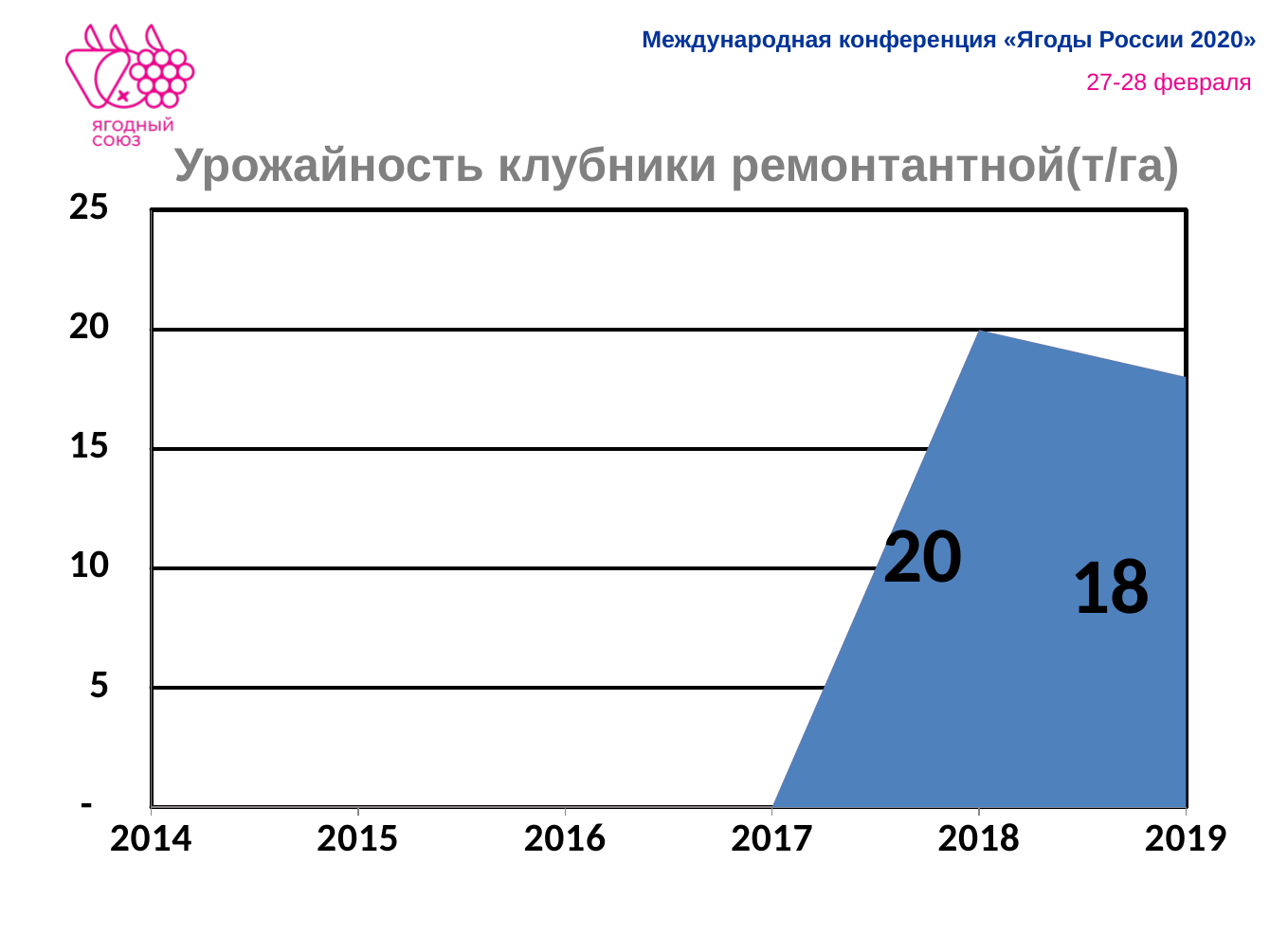
How many years are labelled on the x axis of the chart? 6 Which year has the larger yield value, 2018 or 2019? 2018 What type of chart is shown on the slide? area chart What is the yield value shown for 2018? 20 Is the yield value for 2018 greater or less than 25? less Does the yield value rise or fall from 2018 to 2019? fall Which year has the highest yield value on the chart? 2018 Is the yield value for 2019 greater or less than 15? greater What is the difference between the yield values for 2018 and 2019? 2 What is the maximum value shown on the y axis of the chart? 25 What is the title of the chart? Урожайность клубники ремонтантной(т/га) What is the yield value shown for 2019? 18